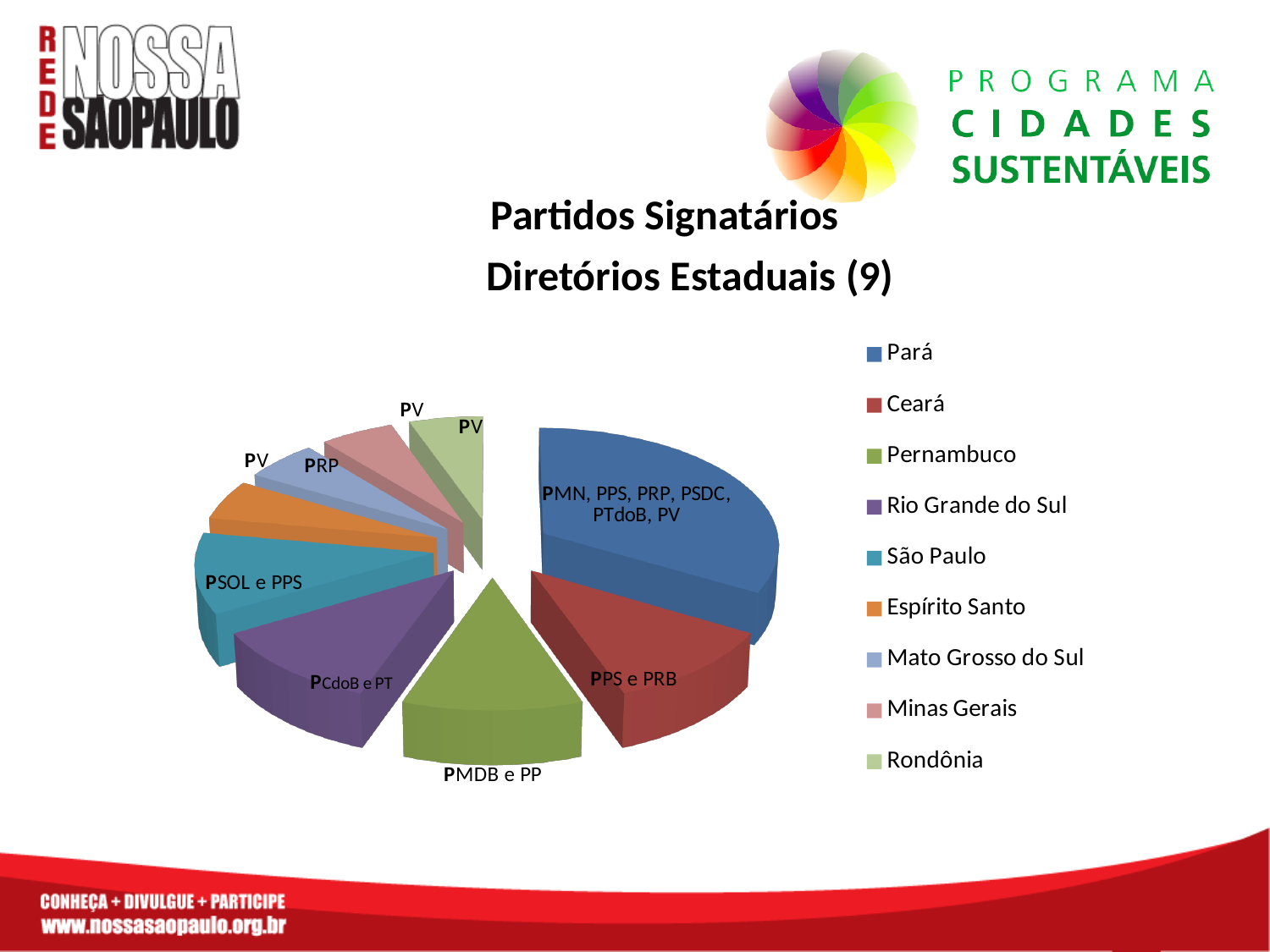
How many entries does the legend of the pie chart list? 9 Which legend entry is listed last in the pie chart's legend? Rondônia Which state has the largest slice in the pie chart? Pará How many slices does the pie chart have? 9 Which parties are labelled on the Ceará slice of the pie chart? PPS e PRB Which parties are labelled on the Pernambuco slice of the pie chart? PMDB e PP Which slice is larger, Rio Grande do Sul or Mato Grosso do Sul? Rio Grande do Sul Which parties are labelled on the Pará slice of the pie chart? PMN, PPS, PRP, PSDC, PTdoB, PV Which slice is larger, Pará or Rondônia? Pará What is the title of the chart on the slide? Partidos Signatários Diretórios Estaduais (9) What kind of chart is shown on the slide? pie chart Which slice is larger, Ceará or Minas Gerais? Ceará